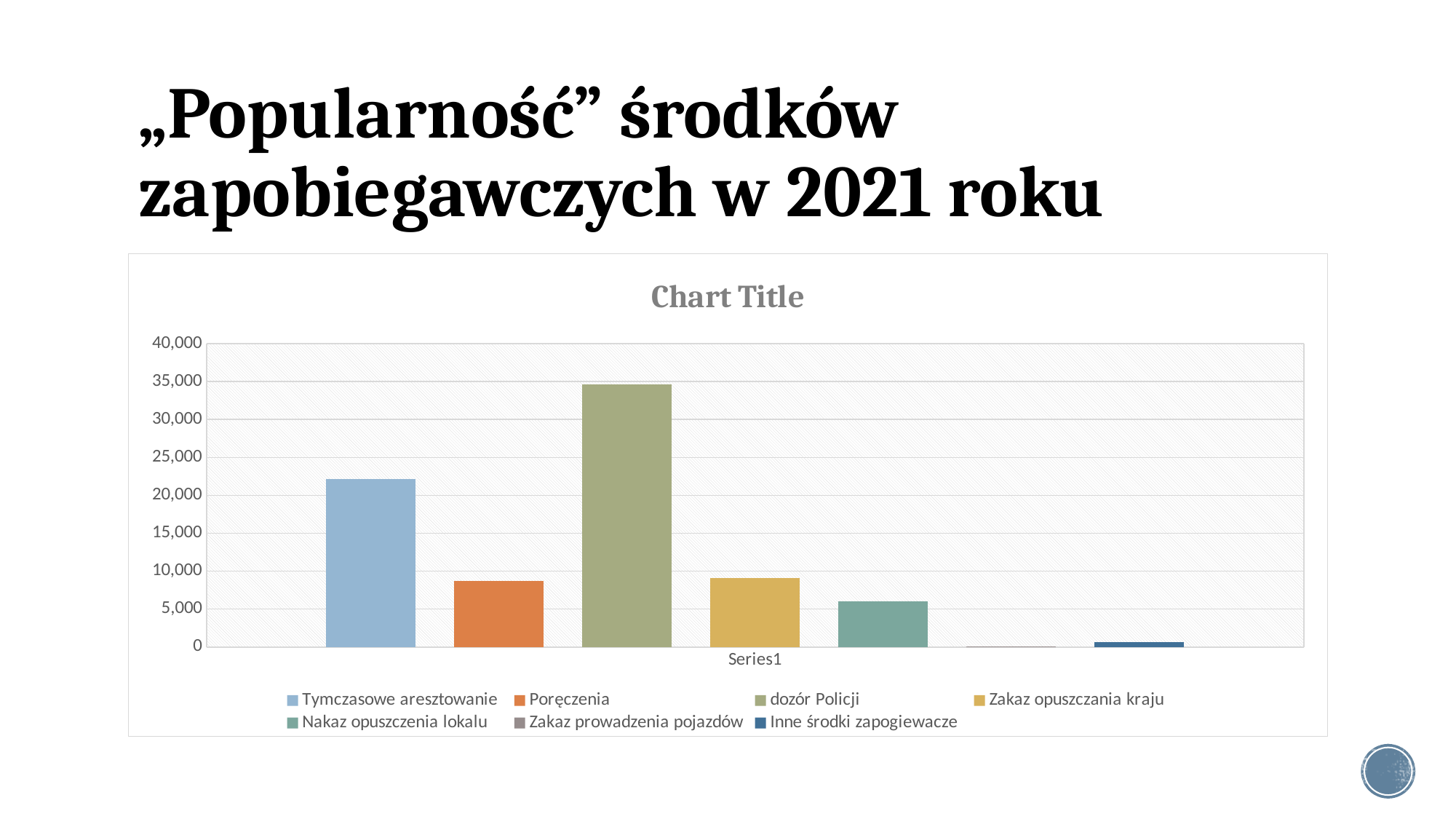
What kind of chart is shown on the slide? bar chart Is the value for Nakaz opuszczenia lokalu greater or less than 5,000? greater What is the title shown above the chart? Chart Title Is the value for dozór Policji greater or less than 30,000? greater Which is larger, the value for Tymczasowe aresztowanie or the value for dozór Policji? dozór Policji How many series does the legend list? 7 How many bars are plotted in the chart? 7 Which legend entry has the tallest bar? dozór Policji Is the value for Inne środki zapogiewacze greater or less than 5,000? less Which legend entry has the shortest bar? Zakaz prowadzenia pojazdów